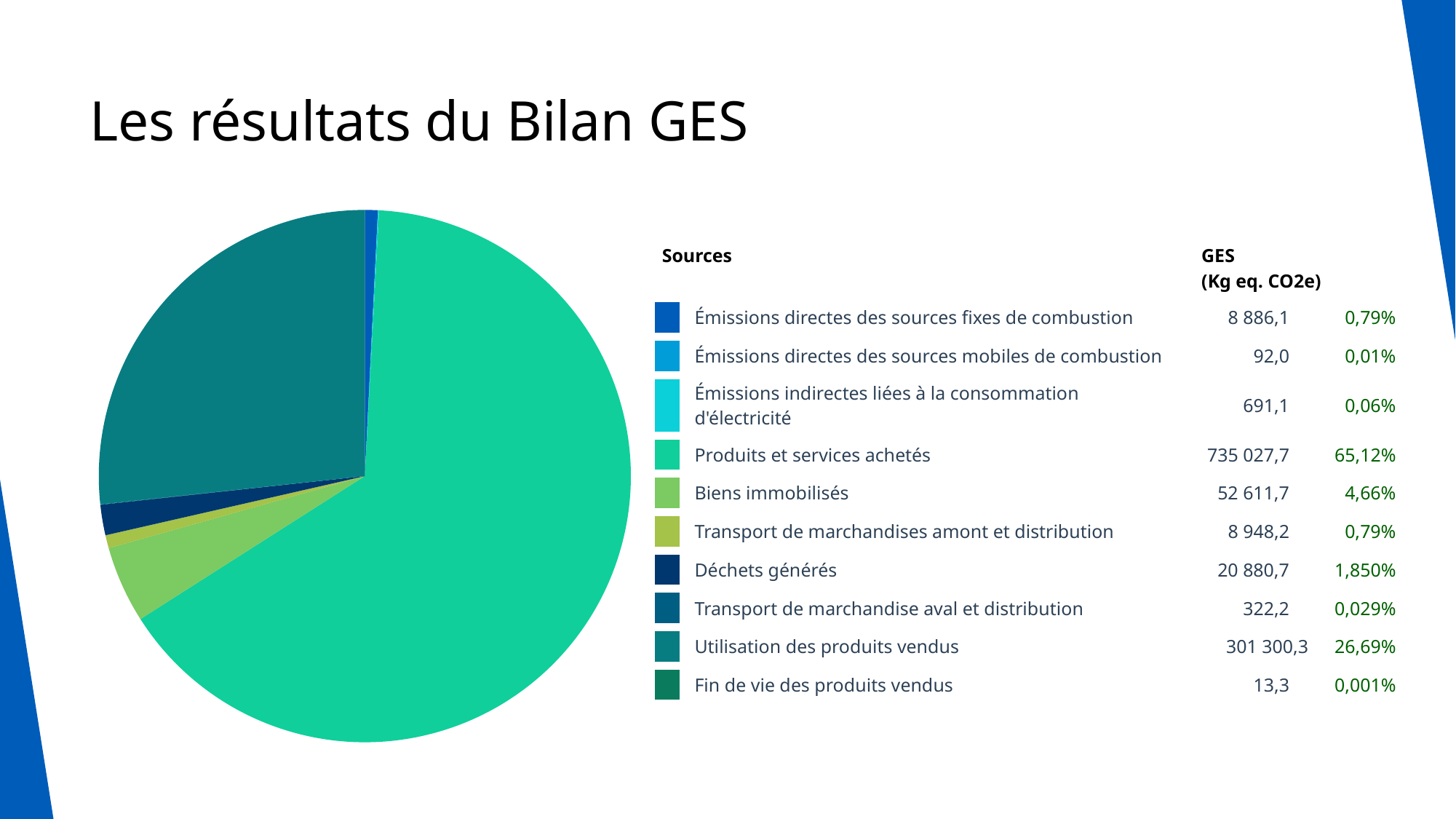
Which source has the lowest GES value? Fin de vie des produits vendus Which source has the highest GES value? Produits et services achetés What share of the pie does Utilisation des produits vendus represent? 26,69% What share of the pie does Produits et services achetés represent? 65,12% What is the GES value (Kg eq. CO2e) for Déchets générés? 20 880,7 What is the difference in GES value between Produits et services achetés and Utilisation des produits vendus? 433 727,4 How many sources are listed in the pie chart legend? 10 Which has a larger GES value, Biens immobilisés or Déchets générés? Biens immobilisés What kind of chart is shown on the slide? pie chart What is the GES value (Kg eq. CO2e) for Utilisation des produits vendus? 301 300,3 What is the title of the slide containing the pie chart? Les résultats du Bilan GES What is the GES value (Kg eq. CO2e) for Produits et services achetés? 735 027,7